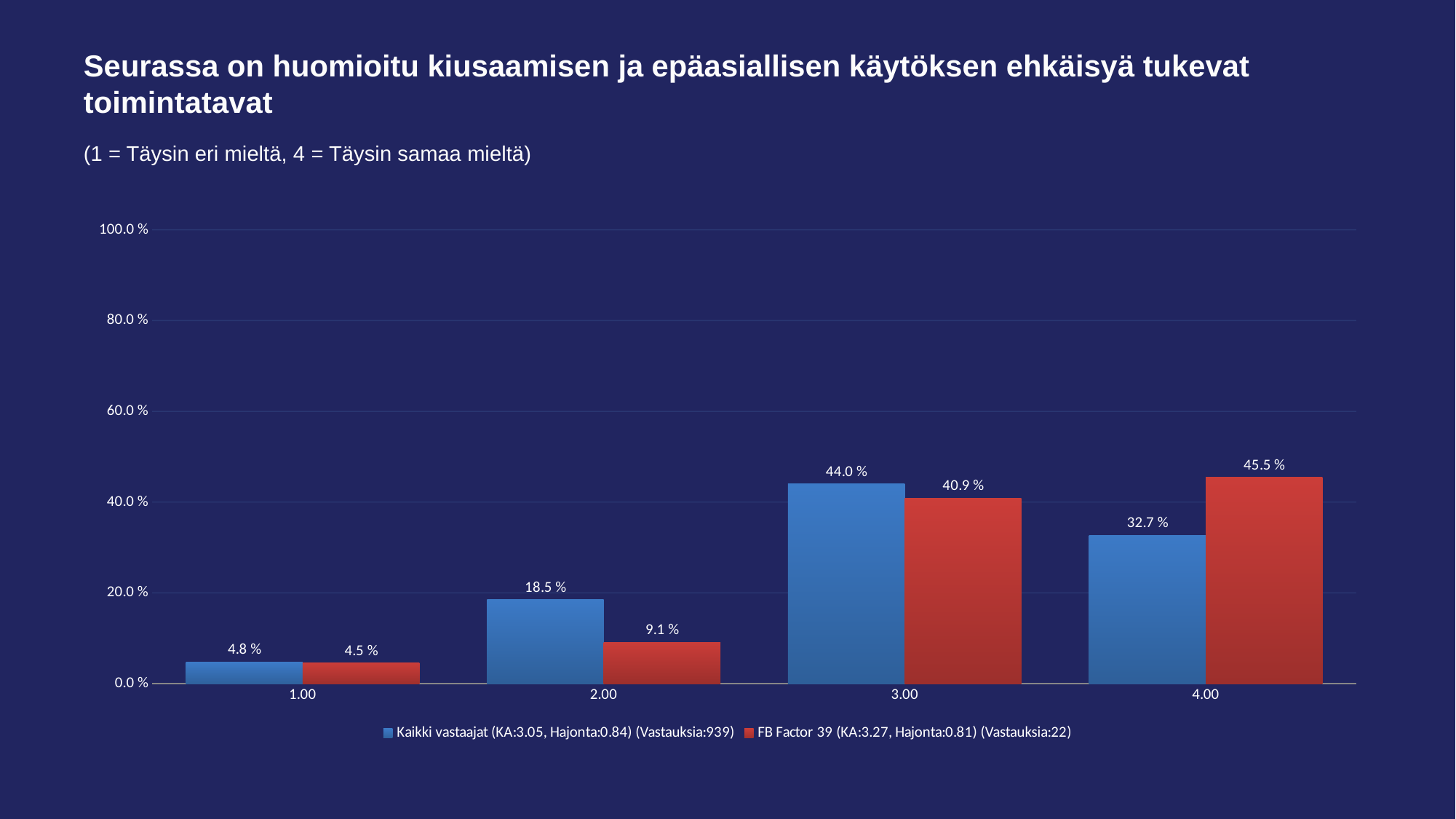
At category 4.00, which series has the larger value, Kaikki vastaajat or FB Factor 39? FB Factor 39 What is the value for FB Factor 39 at category 2.00? 9.1 % How many categories are shown on the x axis? 4 What is the value for FB Factor 39 at category 4.00? 45.5 % Which category has the lowest value for FB Factor 39? 1.00 What colour are the bars for the FB Factor 39 series? Red Which category has the highest value for Kaikki vastaajat? 3.00 What kind of chart is shown on the slide? Bar chart How many series does the legend list? 2 What is the difference between Kaikki vastaajat and FB Factor 39 at category 2.00? 9.4 % Is the value for Kaikki vastaajat at category 3.00 greater or less than 40.0 %? greater What is the value for Kaikki vastaajat at category 3.00? 44.0 %